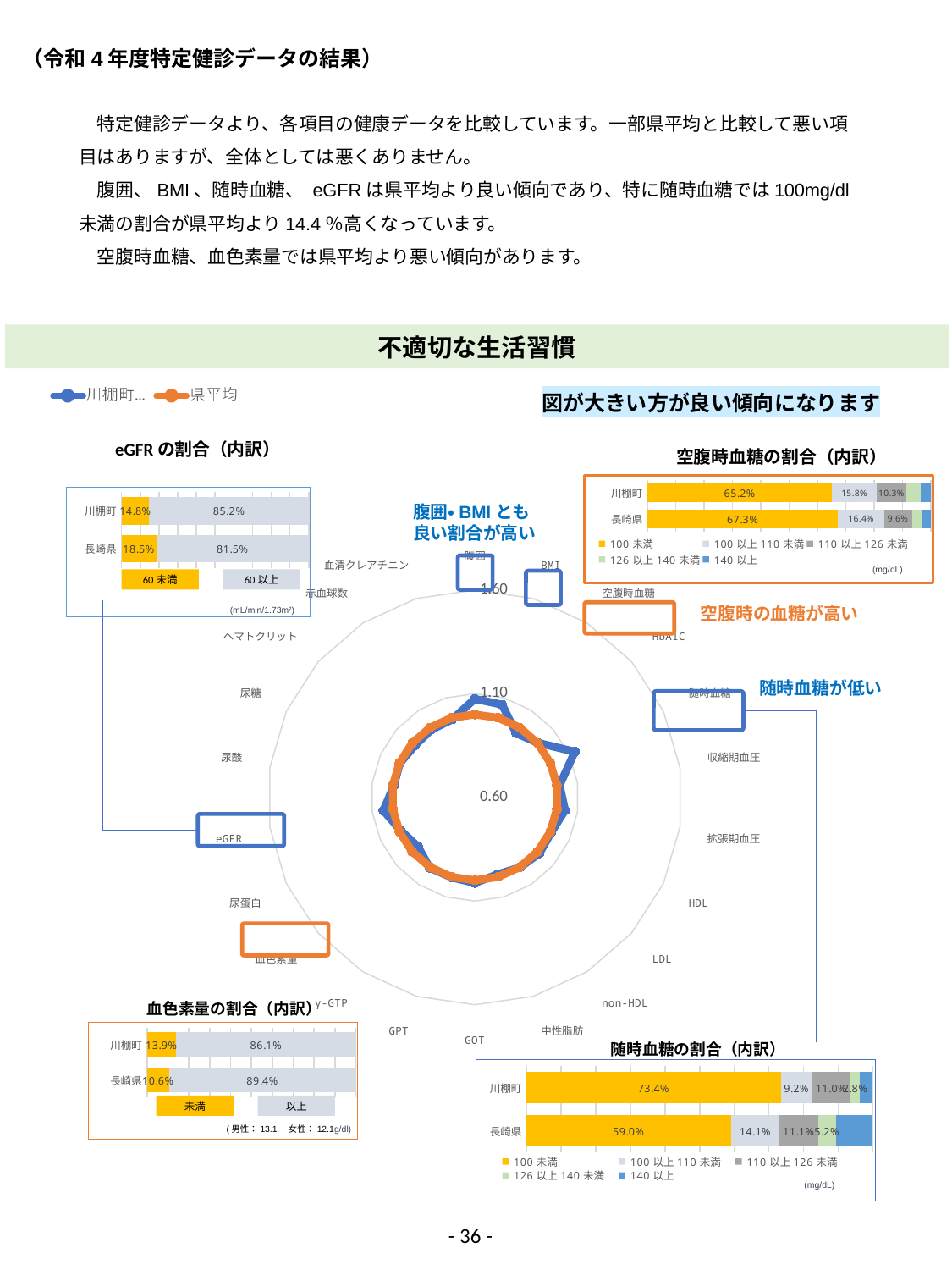
What kind of chart is the large chart in the centre of the slide under 不適切な生活習慣? Radar chart In the 空腹時血糖の割合（内訳） chart, what percentage of 川棚町 is in the 100未満 category? 65.2% In the eGFR の割合（内訳） chart, what percentage of 川棚町 is in the 60未満 category? 14.8% In the 空腹時血糖の割合（内訳） chart, which has the larger 100未満 share, 川棚町 or 長崎県? 長崎県 In the 血色素量の割合（内訳） chart, what percentage of 川棚町 is in the 未満 category? 13.9% In the 随時血糖の割合（内訳） chart, what percentage of 川棚町 is in the 100未満 category? 73.4% In the 血色素量の割合（内訳） chart, which has the larger 以上 share, 川棚町 or 長崎県? 長崎県 How many series does the legend of the central radar chart list? 2 In the eGFR の割合（内訳） chart, what is the difference between the 60未満 percentages for 長崎県 and 川棚町? 3.7 percentage points In the eGFR の割合（内訳） chart, what percentage of 長崎県 is in the 60以上 category? 81.5% In the 随時血糖の割合（内訳） chart, what is the difference between the 100未満 percentages for 川棚町 and 長崎県? 14.4 percentage points